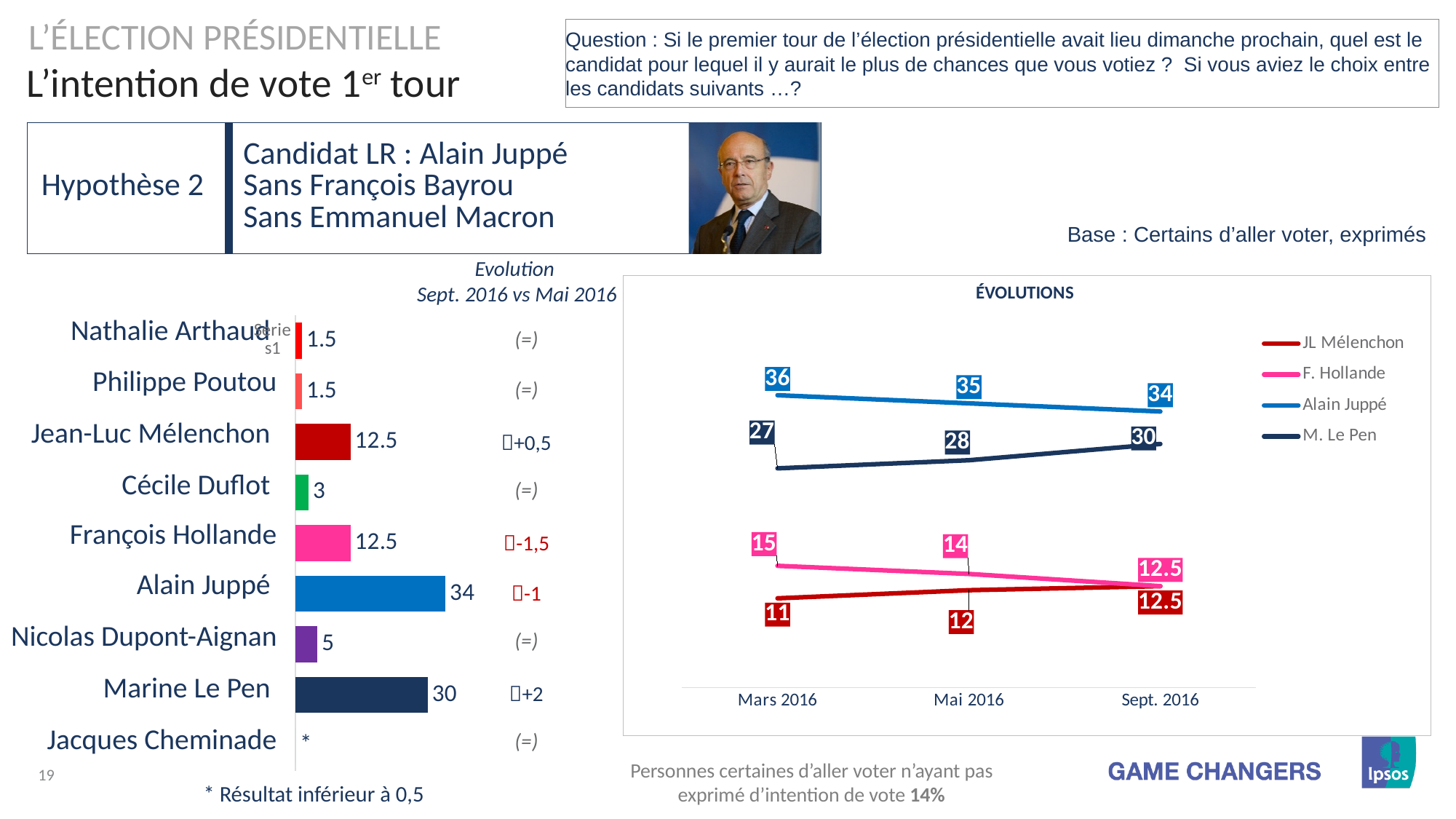
In the bar chart on the left, which is larger: the value for Nicolas Dupont-Aignan or the value for Cécile Duflot? Nicolas Dupont-Aignan In the bar chart on the left, what is the value for Marine Le Pen? 30 In the bar chart on the left, which candidate has the highest value? Alain Juppé In the ÉVOLUTIONS chart, what is the value for F. Hollande in Mars 2016? 15 In the ÉVOLUTIONS chart, what is the difference between the values for Alain Juppé and M. Le Pen in Sept. 2016? 4 In the ÉVOLUTIONS chart, how many time points are shown on the x axis? 3 In the bar chart on the left, what is the difference between the values for Alain Juppé and Marine Le Pen? 4 In the bar chart on the left, what is the value for Alain Juppé? 34 In the ÉVOLUTIONS chart, how many series does the legend list? 4 In the ÉVOLUTIONS chart, what is the value for M. Le Pen in Mai 2016? 28 What kind of chart is the chart on the left of the slide? Bar chart In the ÉVOLUTIONS chart, does the value for Alain Juppé rise or fall from Mars 2016 to Sept. 2016? Fall